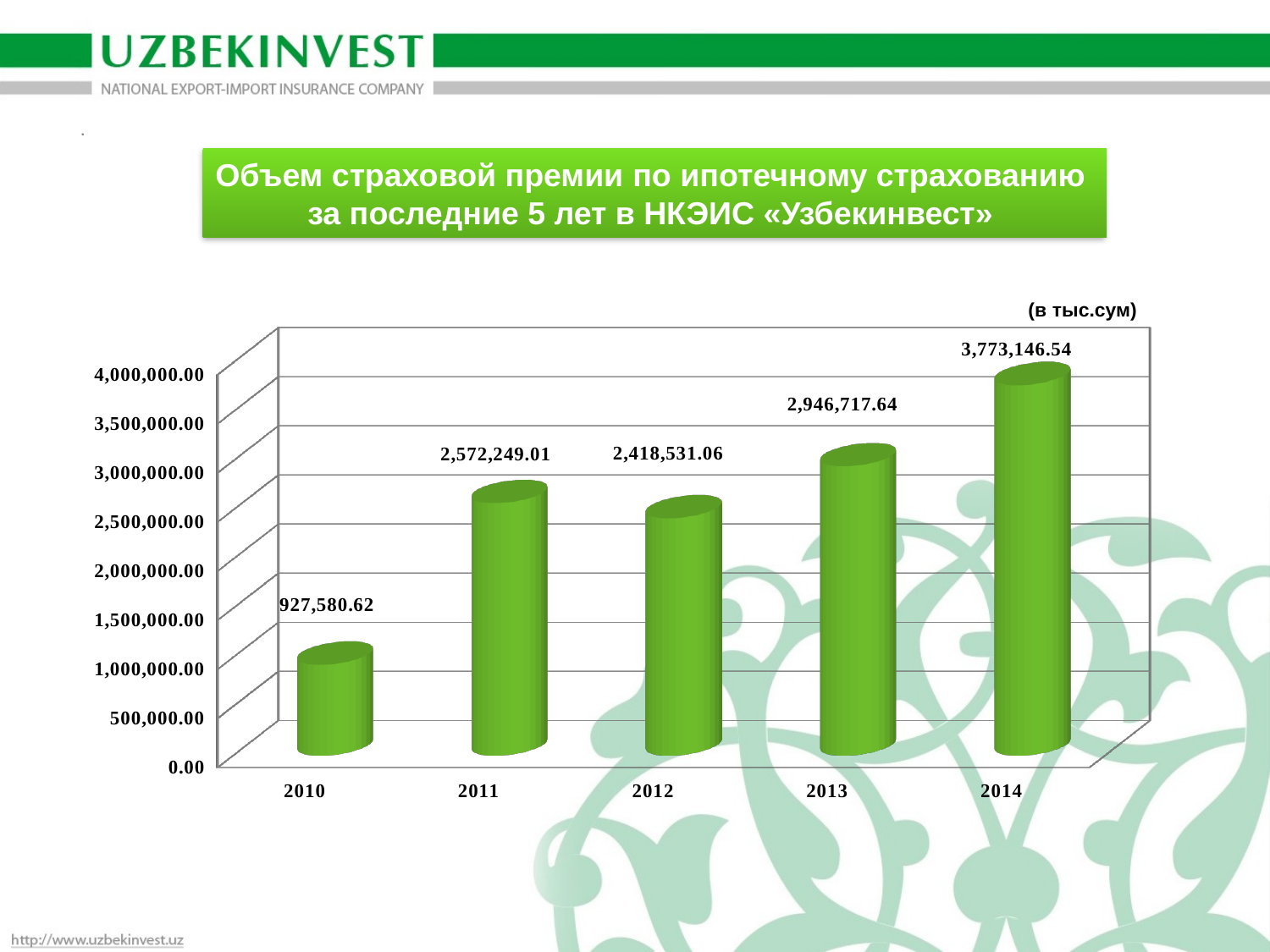
Which year has the highest value? 2014 What is the value for 2012? 2,418,531.06 What is the difference between the values for 2014 and 2013? 826,428.90 What is the difference between the values for 2011 and 2012? 153,717.95 How many years are shown on the x axis? 5 What kind of chart is shown on the slide? bar chart Which is larger, the value for 2011 or the value for 2012? 2011 Which year has the lowest value? 2010 What is the value for 2010? 927,580.62 What unit is stated above the chart? в тыс.сум Is the value for 2010 greater or less than 1,000,000.00? less What is the value for 2014? 3,773,146.54